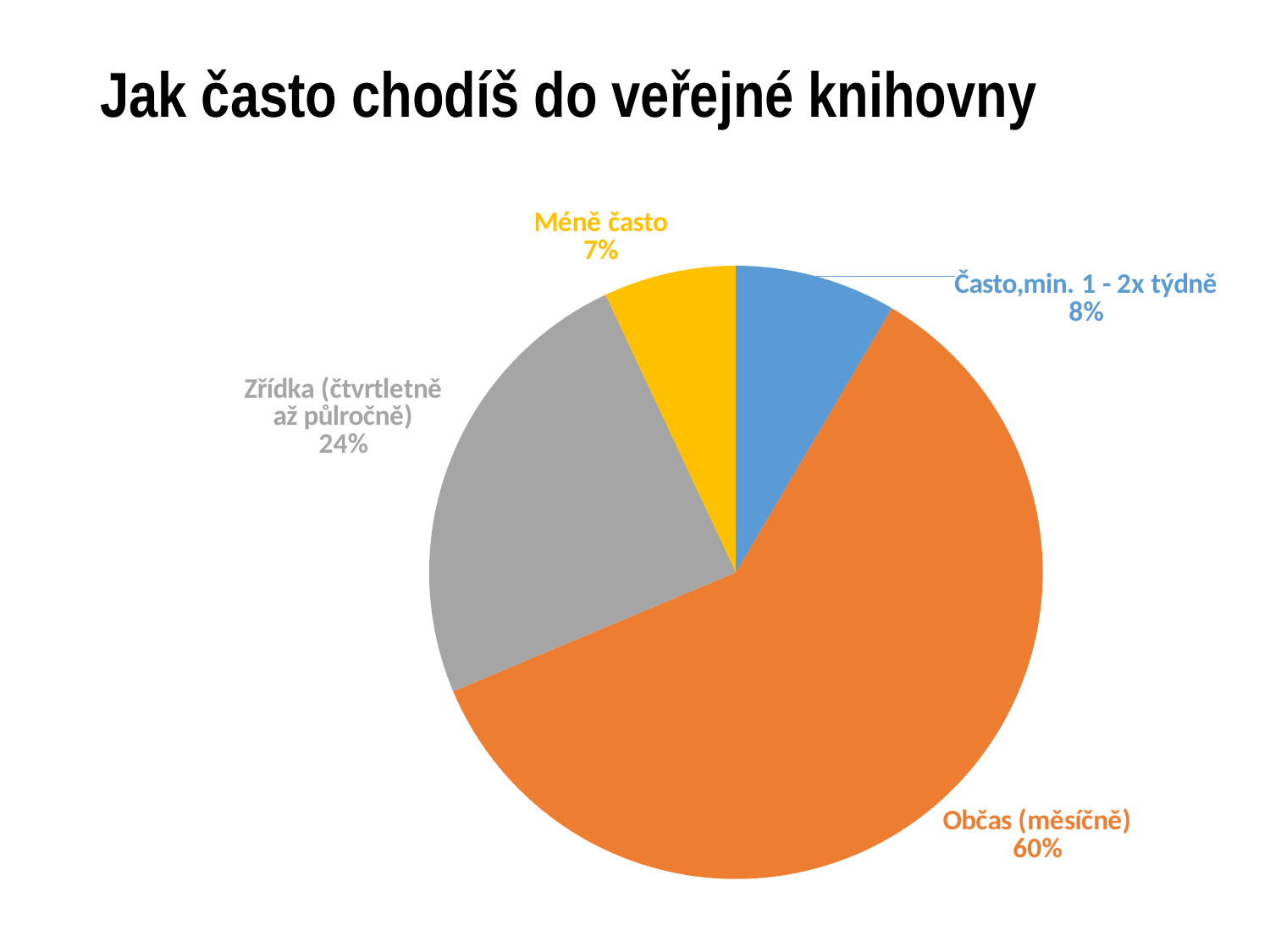
What is the title of the slide? Jak často chodíš do veřejné knihovny What share of the pie does "Zřídka (čtvrtletně až půlročně)" have? 24% What is the difference in percentage points between "Občas (měsíčně)" and "Zřídka (čtvrtletně až půlročně)"? 36 Which is larger, the share for "Zřídka (čtvrtletně až půlročně)" or the share for "Často,min. 1 - 2x týdně"? Zřídka (čtvrtletně až půlročně) What share of the pie does "Často,min. 1 - 2x týdně" have? 8% What kind of chart is shown on the slide? pie chart What colour is the slice for "Občas (měsíčně)"? orange What share of the pie does "Občas (měsíčně)" have? 60% Which category has the smallest slice of the pie? Méně často How many slices does the pie chart have? 4 Which category has the largest slice of the pie? Občas (měsíčně)